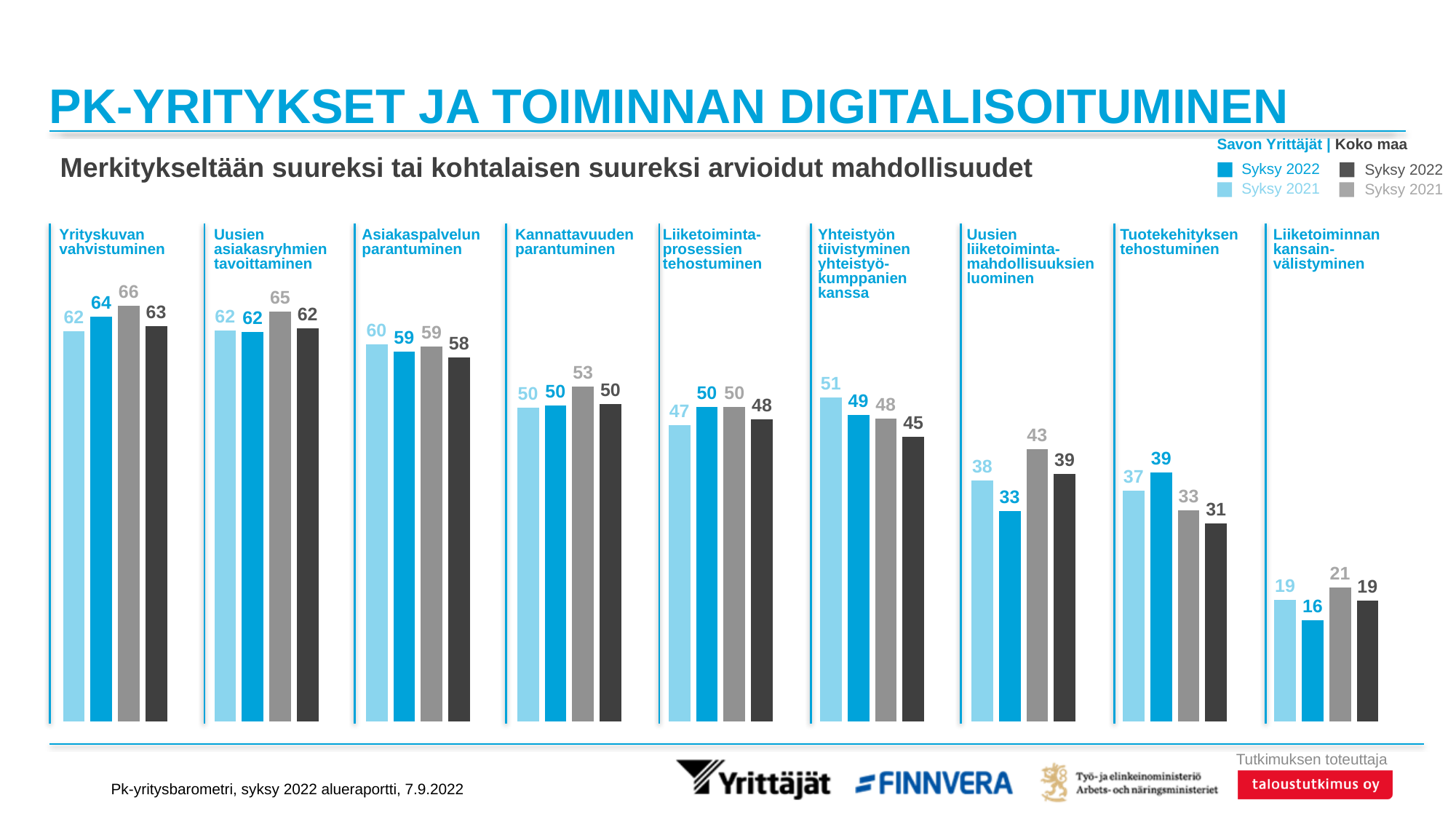
How many categories are shown in the chart? 9 What kind of chart is shown on the slide? Bar chart What is the difference between the Koko maa Syksy 2021 and Savon Yrittäjät Syksy 2022 values for Uusien liiketoimintamahdollisuuksien luominen? 10 What is the Savon Yrittäjät Syksy 2021 value for Liiketoimintaprosessien tehostuminen? 47 How many series does the legend list? 4 For Tuotekehityksen tehostuminen, which is larger: the Savon Yrittäjät Syksy 2022 value or the Koko maa Syksy 2022 value? Savon Yrittäjät Syksy 2022 What is the difference between the Savon Yrittäjät Syksy 2021 and Savon Yrittäjät Syksy 2022 values for Liiketoiminnan kansainvälistyminen? 3 Which category has the lowest Savon Yrittäjät Syksy 2022 value? Liiketoiminnan kansainvälistyminen What is the Koko maa Syksy 2022 value for Yhteistyön tiivistyminen yhteistyökumppanien kanssa? 45 Which category has the highest Koko maa Syksy 2021 value? Yrityskuvan vahvistuminen What is the Savon Yrittäjät Syksy 2022 value for Yrityskuvan vahvistuminen? 64 What is the Koko maa Syksy 2021 value for Uusien liiketoimintamahdollisuuksien luominen? 43